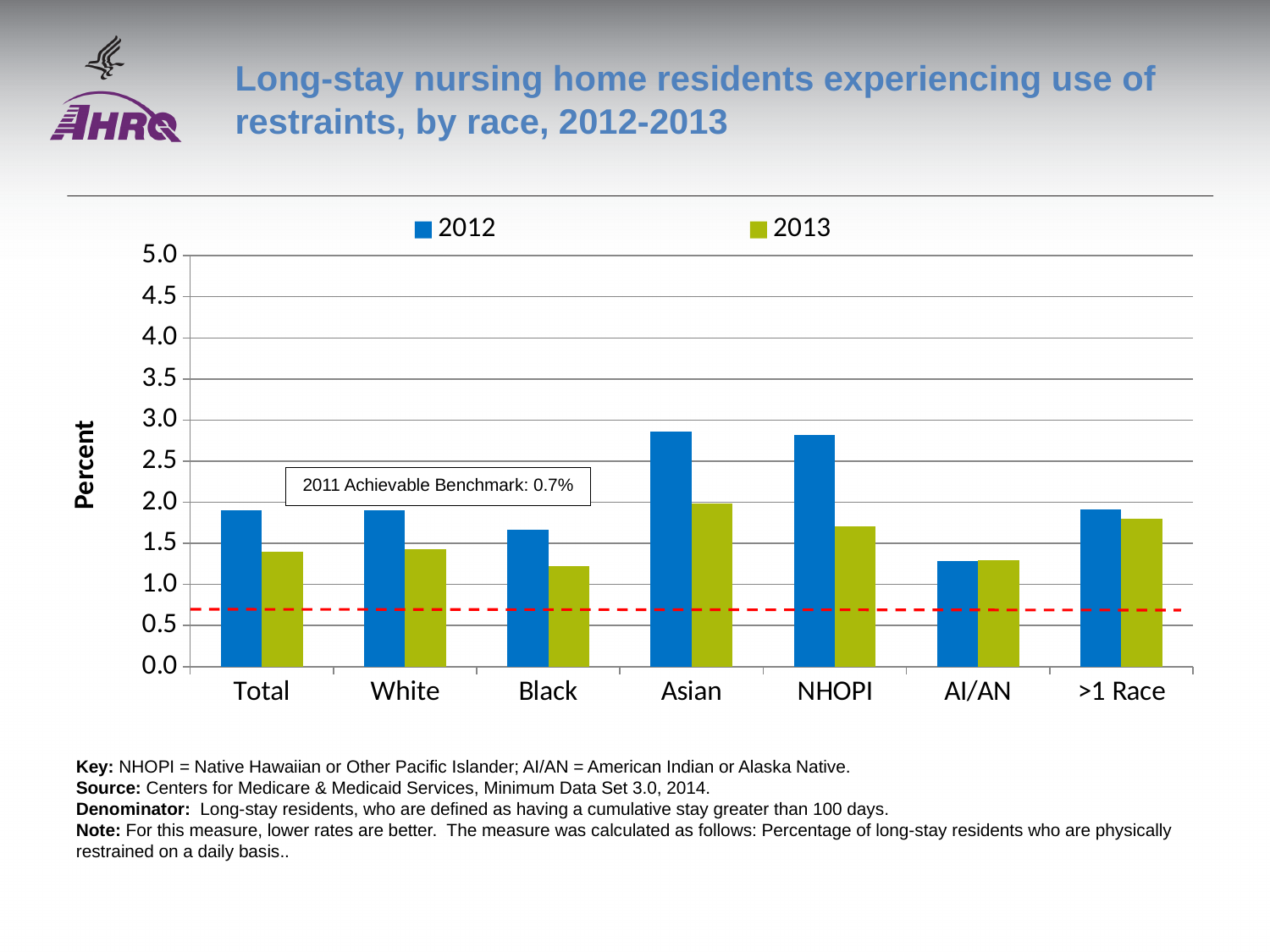
What is the 2011 Achievable Benchmark shown on the chart? 0.7% Which category has the highest value for 2013? Asian Which is larger, the 2012 value for NHOPI or the 2013 value for NHOPI? 2012 How many series does the legend list? 2 Is the 2013 value for Black greater or less than 1.5? less Which category has the lowest value for 2012? AI/AN Is the 2013 value for NHOPI greater or less than 2.0? less Is the 2012 value for Total greater or less than 1.5? greater What kind of chart is shown on the slide? Bar chart How many race categories are shown on the x axis? 7 Which is larger, the 2012 value for Asian or the 2012 value for Black? Asian